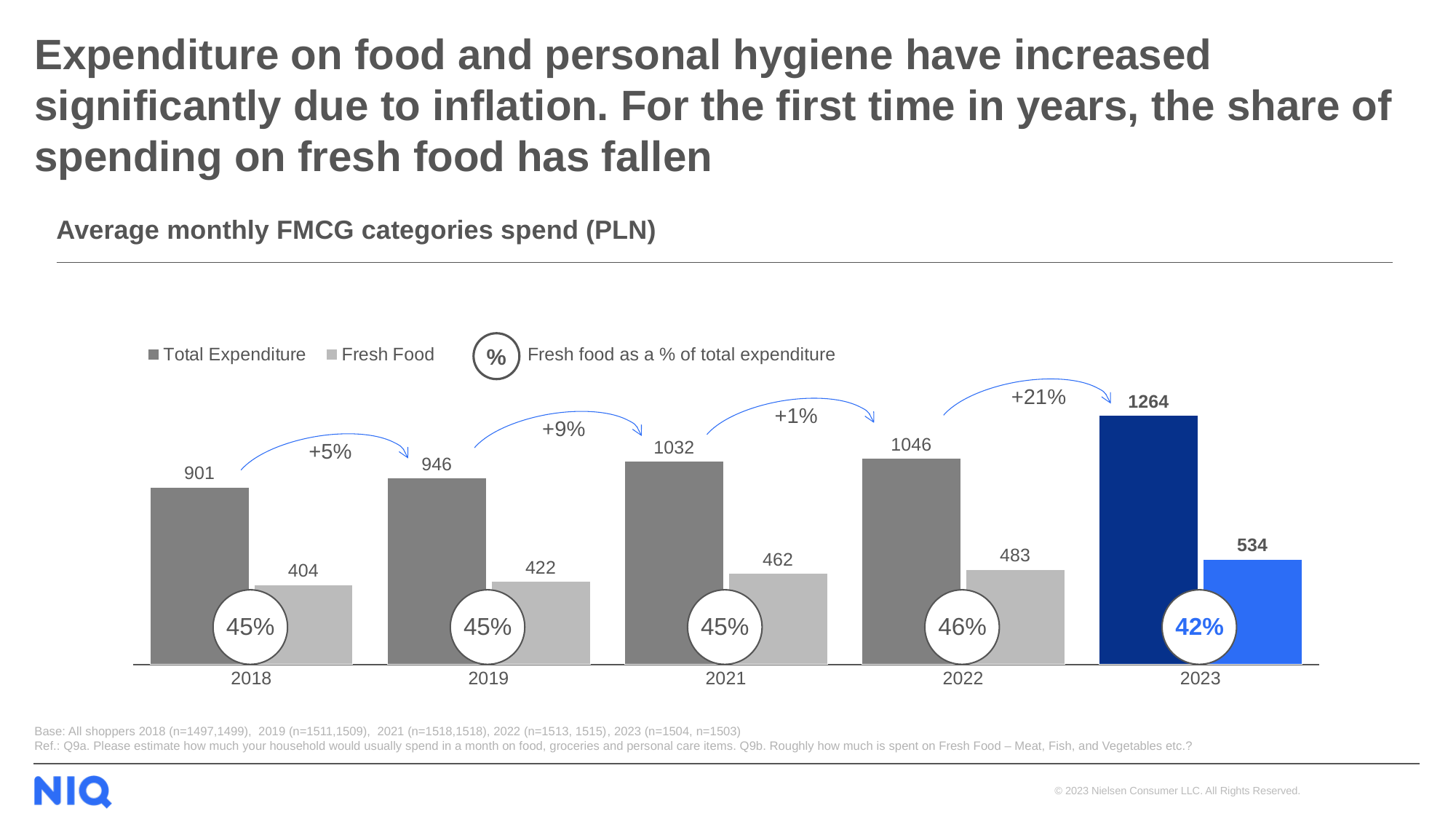
Which year has the lowest Fresh Food value? 2018 What is the Total Expenditure value for 2018? 901 How many series does the legend list? 2 What is fresh food as a % of total expenditure in 2023? 42% Which year has the highest Total Expenditure? 2023 Which is larger, the Fresh Food value for 2019 or for 2022? 2022 What kind of chart is shown on the slide? Bar chart What is the Fresh Food value for 2021? 462 By how much did Total Expenditure increase from 2019 to 2021? 86 What is the difference between Total Expenditure and Fresh Food in 2022? 563 How many years are shown on the x axis? 5 What is the Fresh Food value for 2023? 534